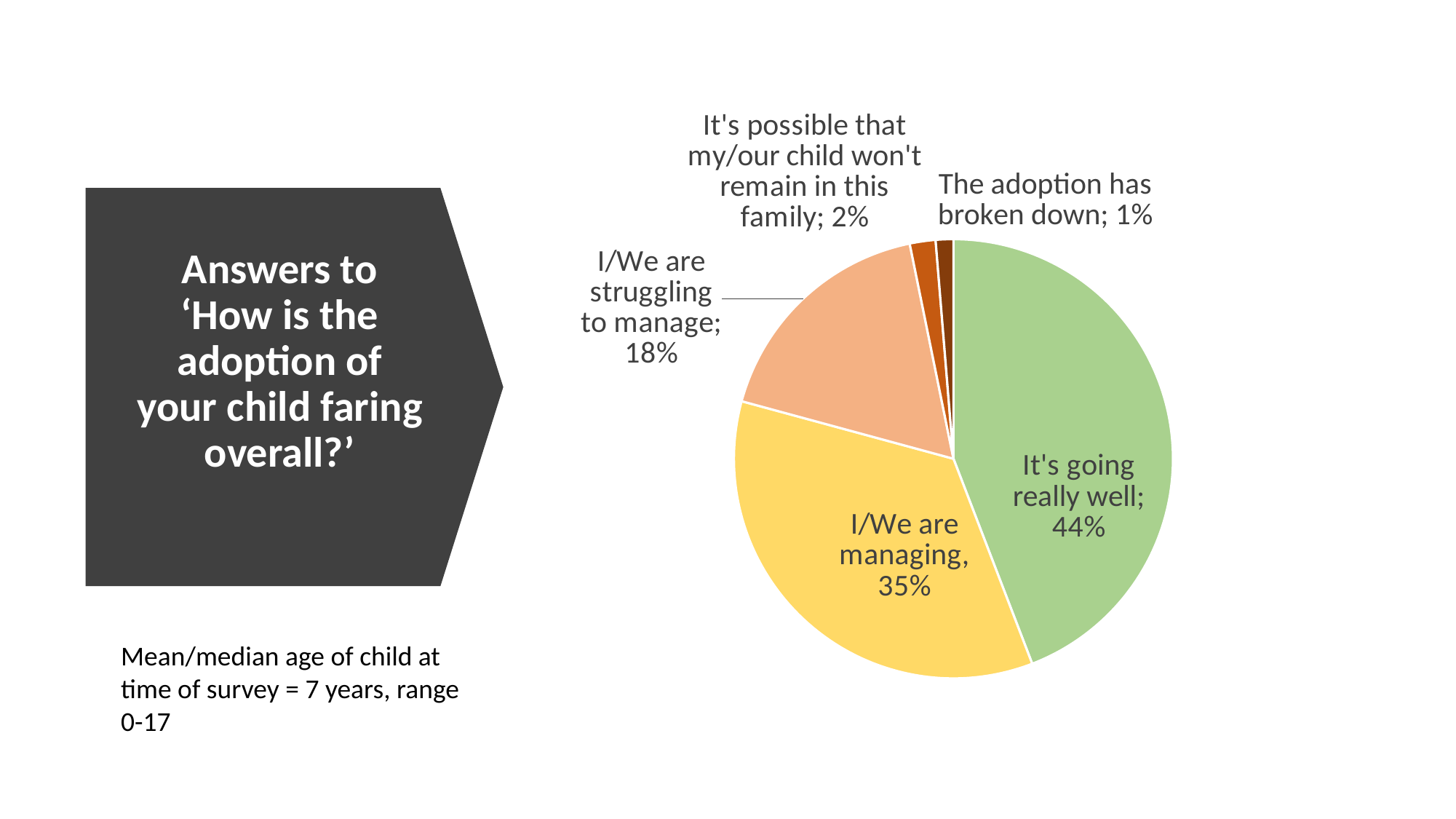
How many slices does the pie chart have? 5 What is the difference in percentage points between 'It's going really well' and 'I/We are managing'? 9 What colour is the slice for 'It's going really well'? green What percentage of respondents answered 'I/We are struggling to manage'? 18% What percentage of respondents answered 'The adoption has broken down'? 1% Which answer has the smallest share of the pie? The adoption has broken down What percentage of respondents answered 'It's possible that my/our child won't remain in this family'? 2% What percentage of respondents answered 'I/We are managing'? 35% What percentage of respondents answered 'It's going really well'? 44% Which is larger: the share for 'I/We are struggling to manage' or the share for 'I/We are managing'? I/We are managing Which answer has the largest share of the pie? It's going really well What kind of chart is shown on the slide? pie chart